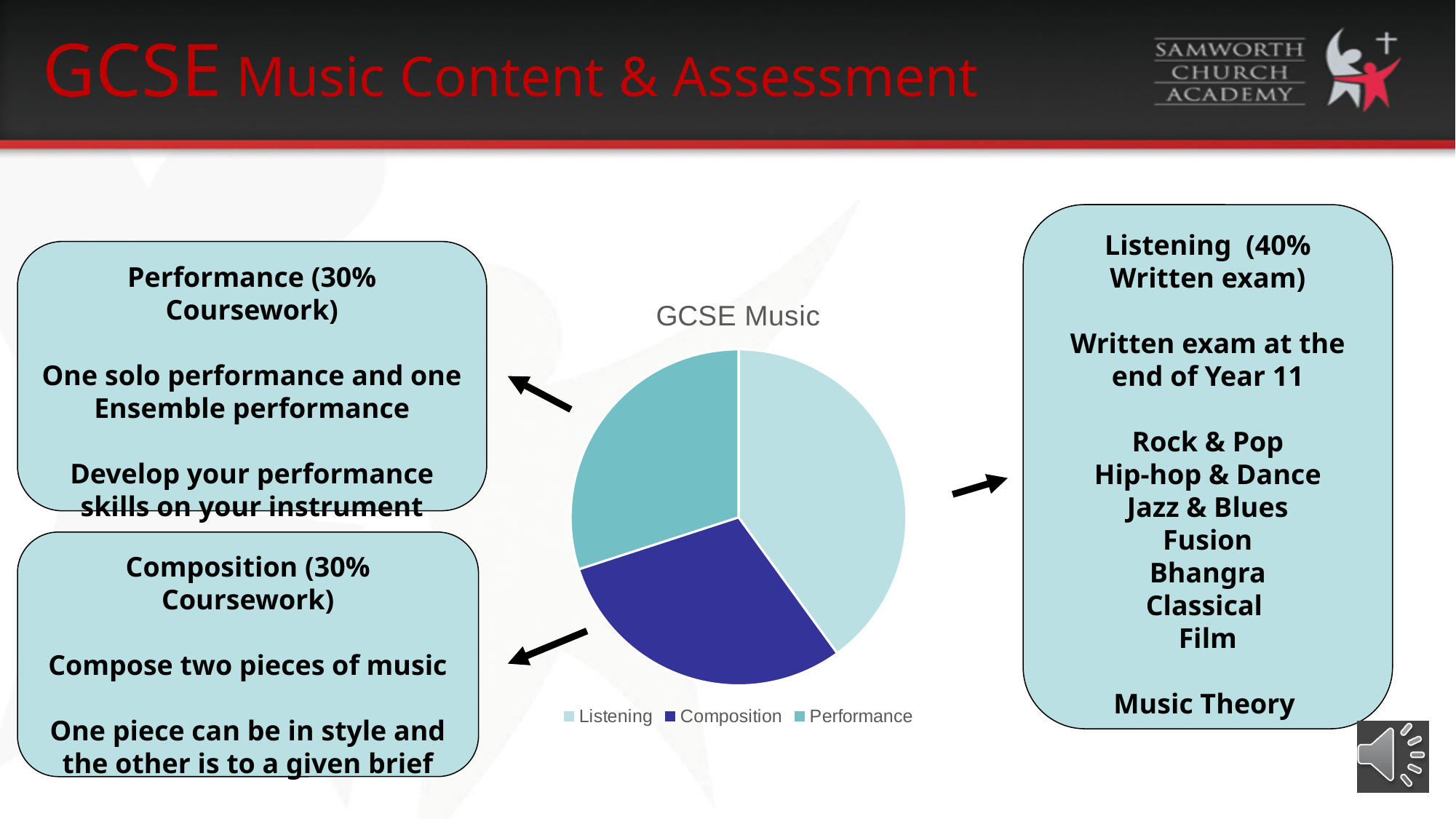
According to the slide, what share of GCSE Music does the Composition slice represent? 30% How many slices does the pie chart have? 3 What is the title of the chart? GCSE Music Which legend entry is shown in dark blue? Composition What is the difference between the Listening share and the Composition share shown on the slide? 10% How many entries does the chart legend list? 3 According to the slide, what share of GCSE Music does the Listening slice represent? 40% Which slice of the pie chart is the largest? Listening What kind of chart is shown on the slide? pie chart Which is larger in the pie chart, Listening or Performance? Listening According to the slide, what share of GCSE Music does the Performance slice represent? 30% Which is larger in the pie chart, Listening or Composition? Listening